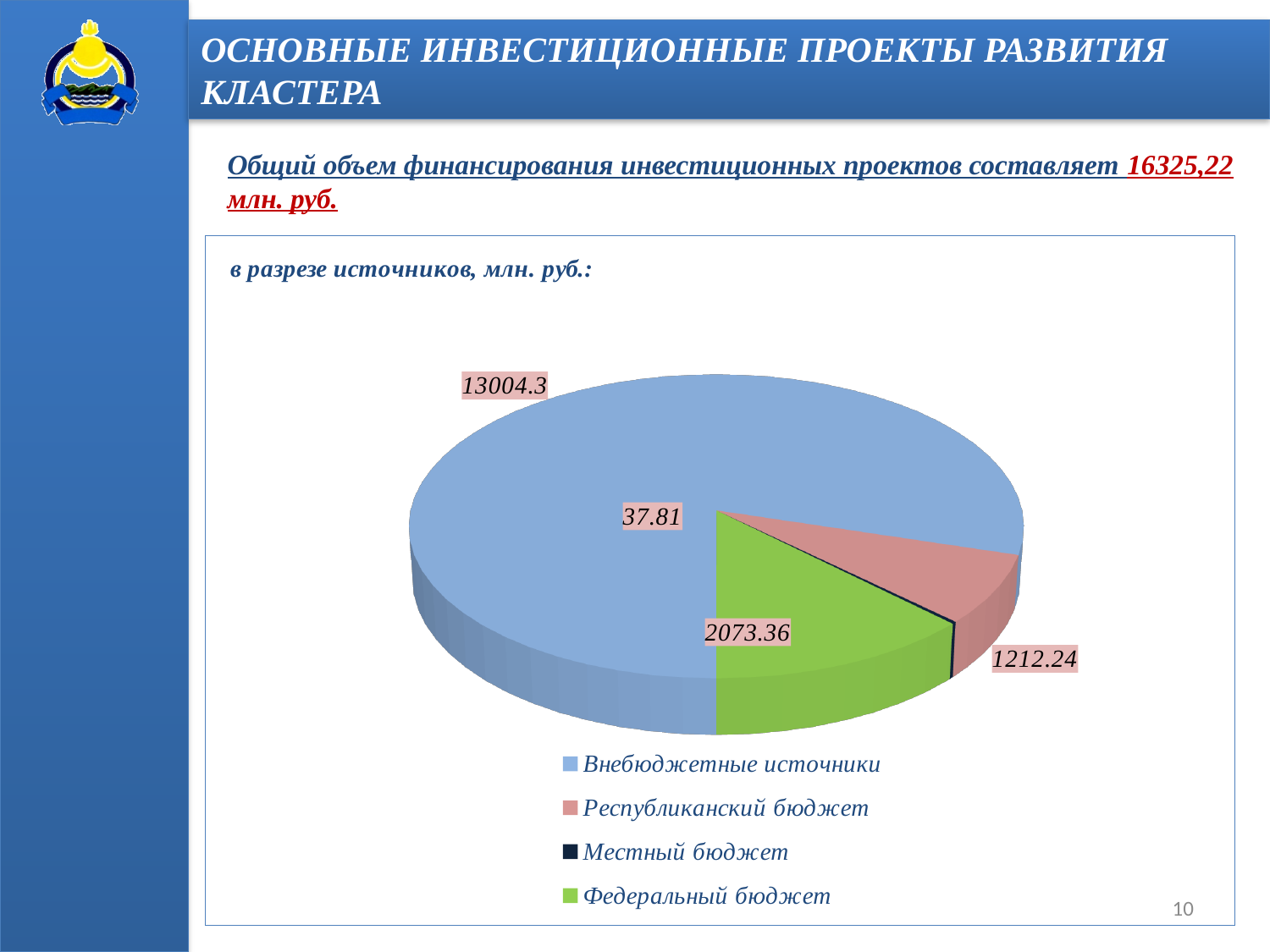
How many entries does the legend of the pie chart list? 4 What colour is the slice for Федеральный бюджет in the pie chart? green How many slices does the pie chart have? 4 Which source has the largest slice in the pie chart? Внебюджетные источники What is the value for Республиканский бюджет in the pie chart? 1212.24 What is the value for Федеральный бюджет in the pie chart? 2073.36 Which source has the smallest slice in the pie chart? Местный бюджет What is the value for Внебюджетные источники in the pie chart? 13004.3 What kind of chart is shown on the slide? pie chart What is the difference between the values for Федеральный бюджет and Республиканский бюджет in the pie chart? 861.12 Which is larger in the pie chart: Федеральный бюджет or Республиканский бюджет? Федеральный бюджет What is the value for Местный бюджет in the pie chart? 37.81